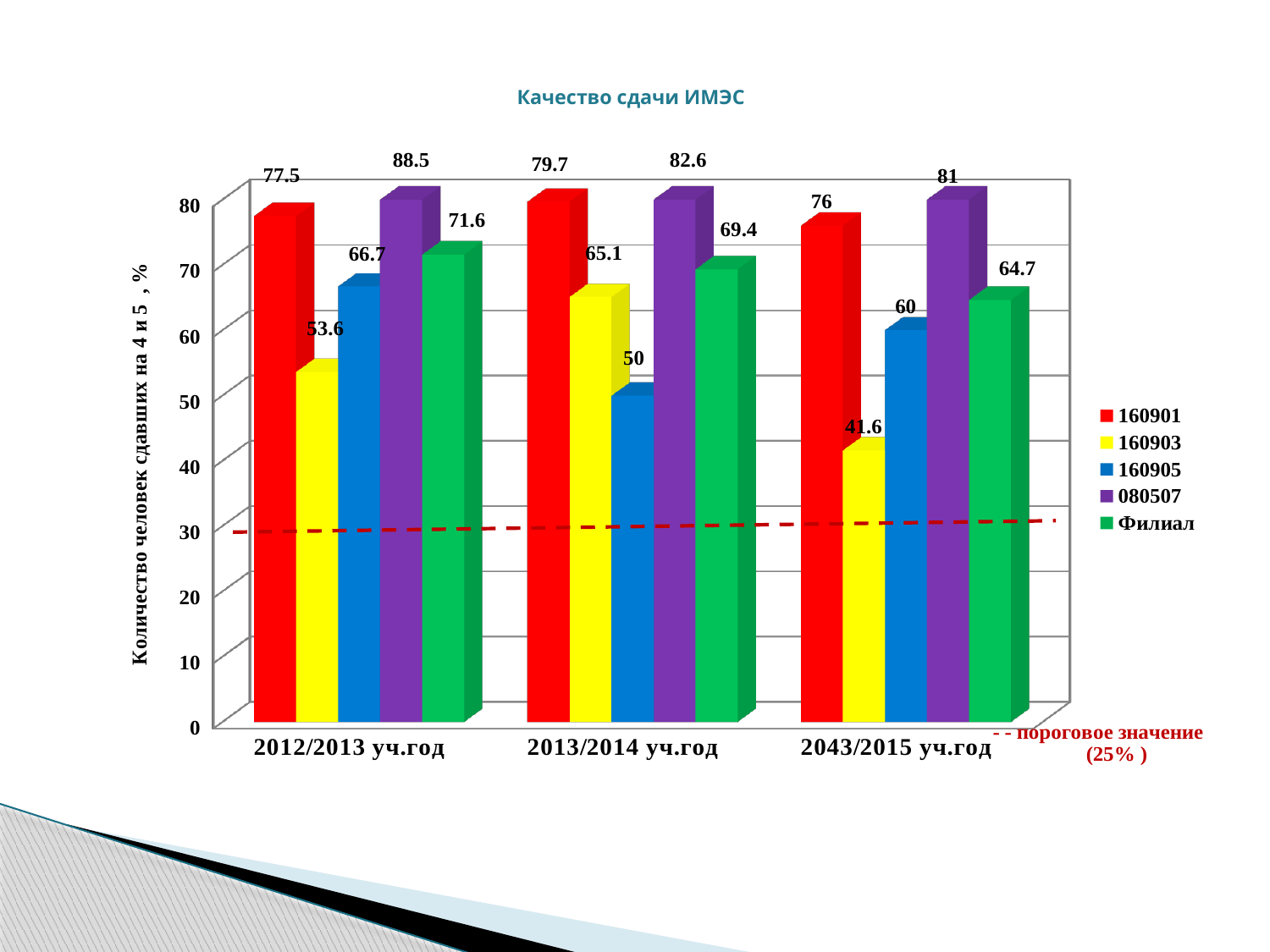
What kind of chart is shown on the slide? Bar chart How many series does the legend list? 5 What is the value for Филиал in 2013/2014 уч.год? 69.4 How many categories are shown on the x axis? 3 What is the value for series 080507 in 2013/2014 уч.год? 82.6 Which series has the highest value in 2012/2013 уч.год? 080507 Which is larger in 2013/2014 уч.год: the value for 160905 or the value for 160903? 160903 What is the value for series 160901 in 2012/2013 уч.год? 77.5 What is the value for series 160903 in 2043/2015 уч.год? 41.6 What is the difference between the values for 080507 and 160903 in 2012/2013 уч.год? 34.9 Do the values for series 160903 rise or fall from 2013/2014 уч.год to 2043/2015 уч.год? Fall Which series has the lowest value in 2043/2015 уч.год? 160903